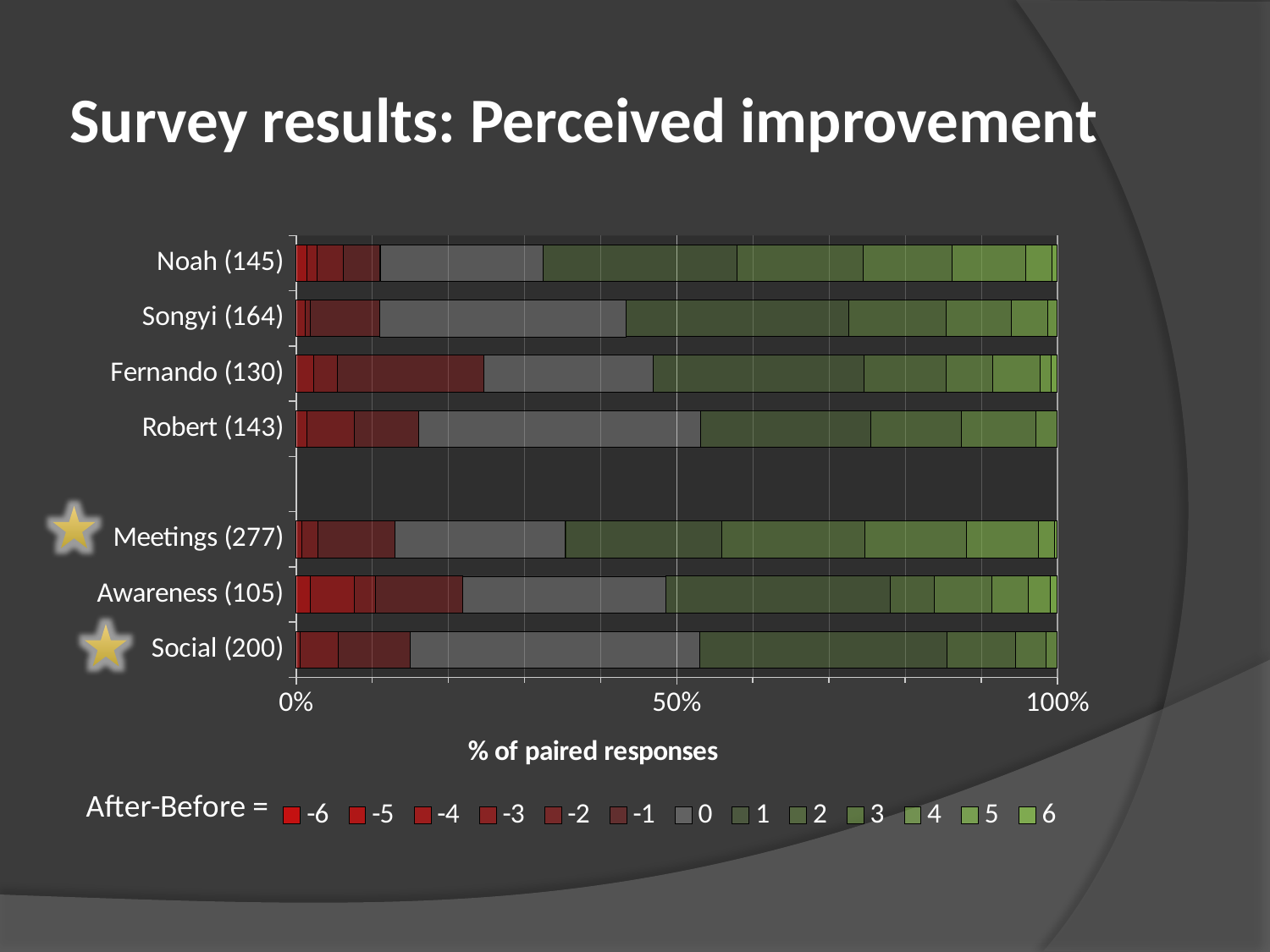
Which category has the largest number shown in parentheses in its label? Meetings (277) What number appears in parentheses next to the Meetings category? 277 How many series does the legend list? 13 How many categories (bars) are plotted in the chart? 7 What is the title of the slide's chart? Survey results: Perceived improvement Is the combined share of negative and zero responses (red and grey segments) for Noah greater or less than 50%? less What is the label on the horizontal axis? % of paired responses What kind of chart is shown on the slide? Stacked bar chart Which has a larger share of negative (red) responses, Fernando or Songyi? Fernando Is the share of positive responses (green segments) for Noah greater or less than 50%? greater What number appears in parentheses next to the Awareness category? 105 Which category has the smallest number shown in parentheses in its label? Awareness (105)